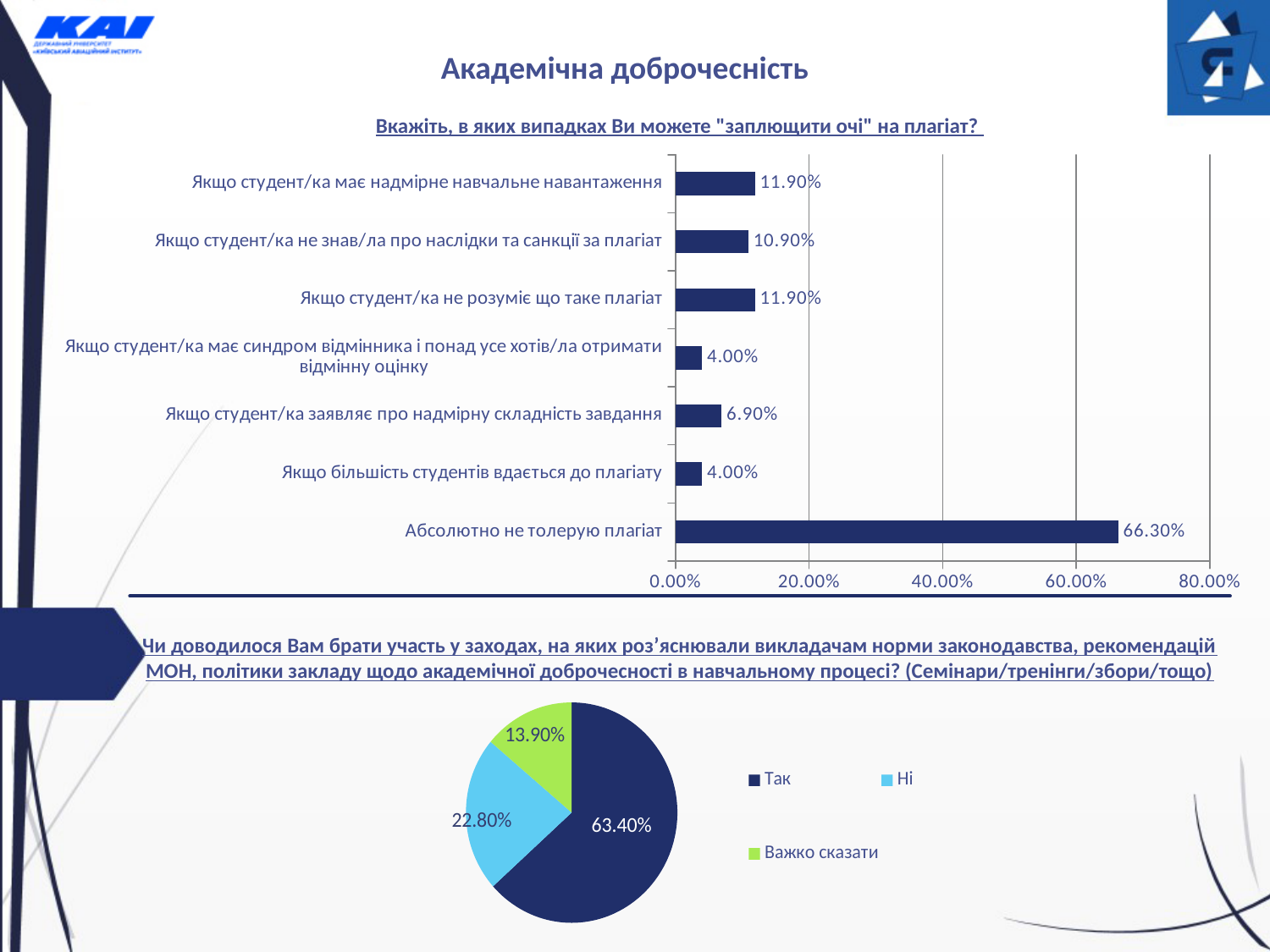
In the top bar chart, what is the difference between "Абсолютно не толерую плагіат" and "Якщо студент/ка не розуміє що таке плагіат"? 54.40% In the top bar chart, which is larger: "Якщо студент/ка не знав/ла про наслідки та санкції за плагіат" or "Якщо студент/ка заявляє про надмірну складність завдання"? Якщо студент/ка не знав/ла про наслідки та санкції за плагіат What type of chart is the top chart on the slide? bar chart In the bottom pie chart, what is the difference between "Так" and "Ні"? 40.60% In the bottom pie chart, what share does "Важко сказати" have? 13.90% In the top bar chart, which category has the highest value? Абсолютно не толерую плагіат In the top bar chart, what is the value for "Якщо студент/ка заявляє про надмірну складність завдання"? 6.90% In the top bar chart, what is the value for "Якщо студент/ка не знав/ла про наслідки та санкції за плагіат"? 10.90% How many categories does the top bar chart show? 7 In the bottom pie chart, what share does "Так" have? 63.40% In the bottom pie chart, which slice is the smallest? Важко сказати In the top bar chart, what is the value for "Абсолютно не толерую плагіат"? 66.30%